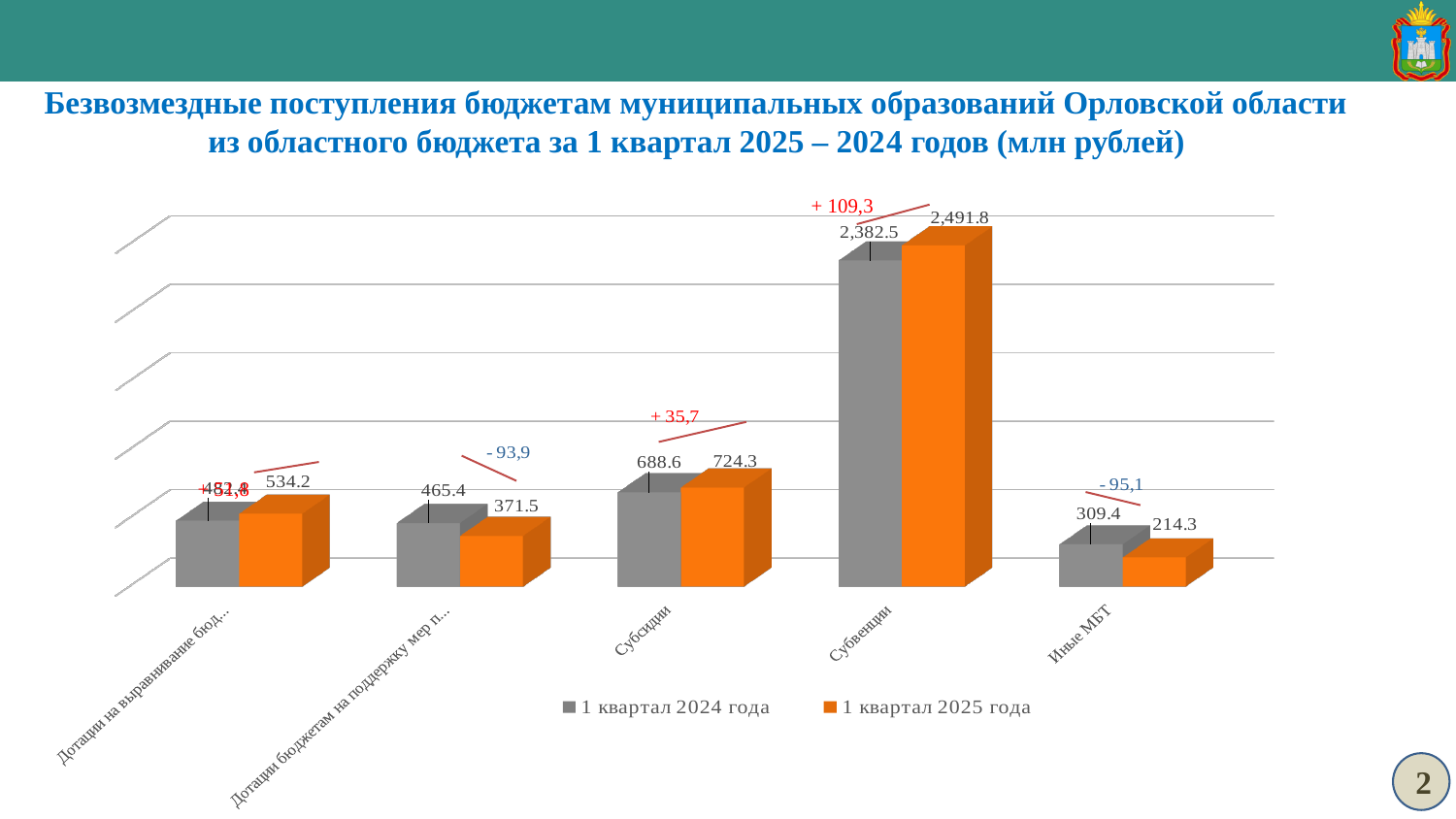
What is the difference between the 1 квартал 2025 года and 1 квартал 2024 года values for Субсидии? 35.7 How many series does the legend list? 2 How many categories are shown on the x axis? 5 What is the value for Субвенции in 1 квартал 2025 года? 2,491.8 What is the value for Субсидии in 1 квартал 2024 года? 688.6 What type of chart is shown on the slide? bar chart Which category has the highest value in 1 квартал 2025 года? Субвенции For Иные МБТ, which is larger: the 1 квартал 2024 года value or the 1 квартал 2025 года value? 1 квартал 2024 года Which category has the lowest value in 1 квартал 2024 года? Иные МБТ What is the value for Иные МБТ in 1 квартал 2025 года? 214.3 Which colour represents the series 1 квартал 2025 года? orange What is the value for Субвенции in 1 квартал 2024 года? 2,382.5